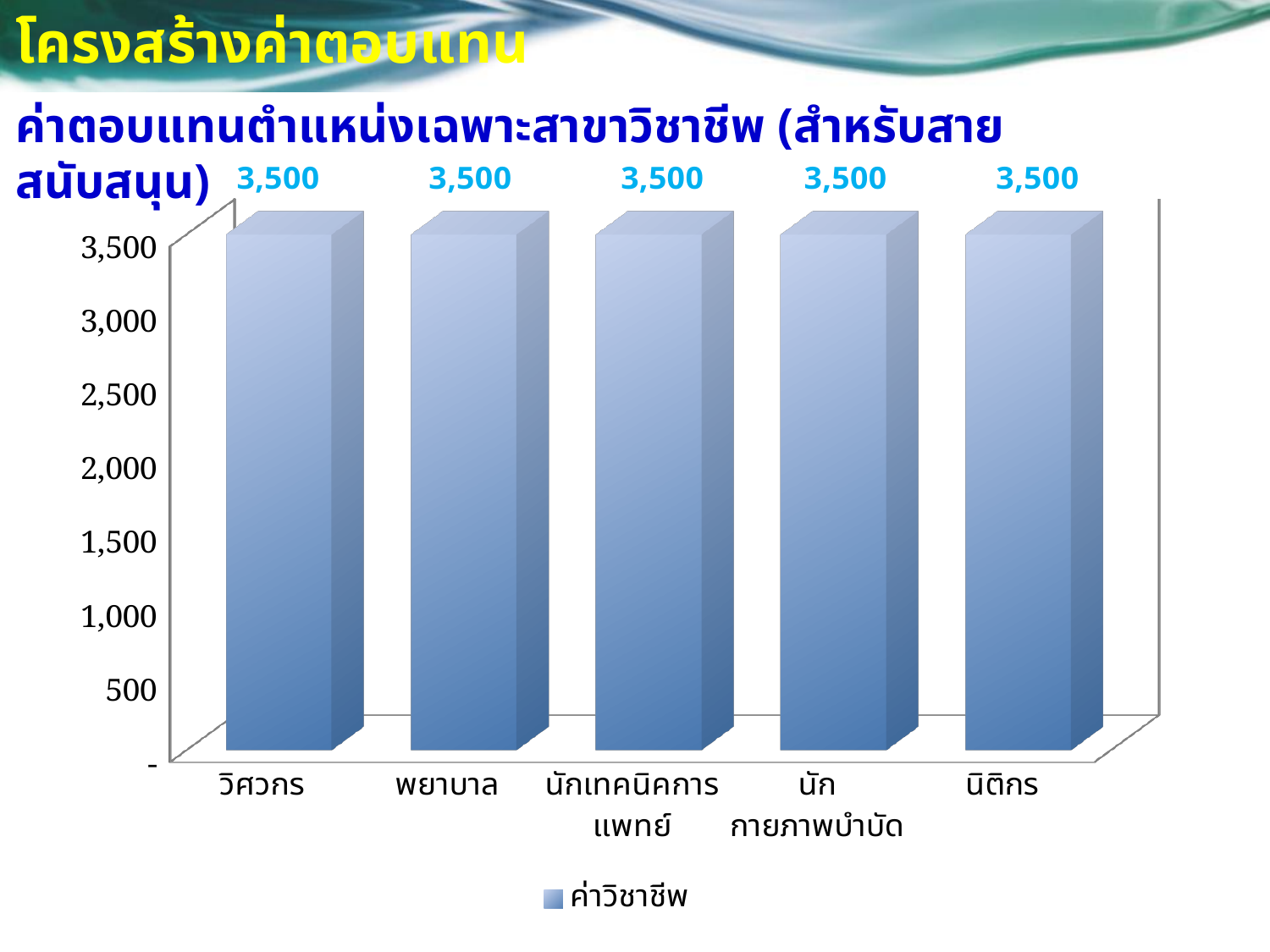
What kind of chart is shown on the slide? bar chart Do the values rise, fall, or stay the same across the categories from left to right? stay the same What is the value for นักเทคนิคการแพทย์? 3,500 What is the name of the series listed in the legend? ค่าวิชาชีพ How many categories are shown on the x axis? 5 What is the value for นิติกร? 3,500 What is the value for พยาบาล? 3,500 What is the value for นักกายภาพบำบัด? 3,500 What is the value for วิศวกร? 3,500 Is the value for พยาบาล greater or less than 3,000? greater How many series does the legend list? 1 What is the difference between the values for วิศวกร and นิติกร? 0